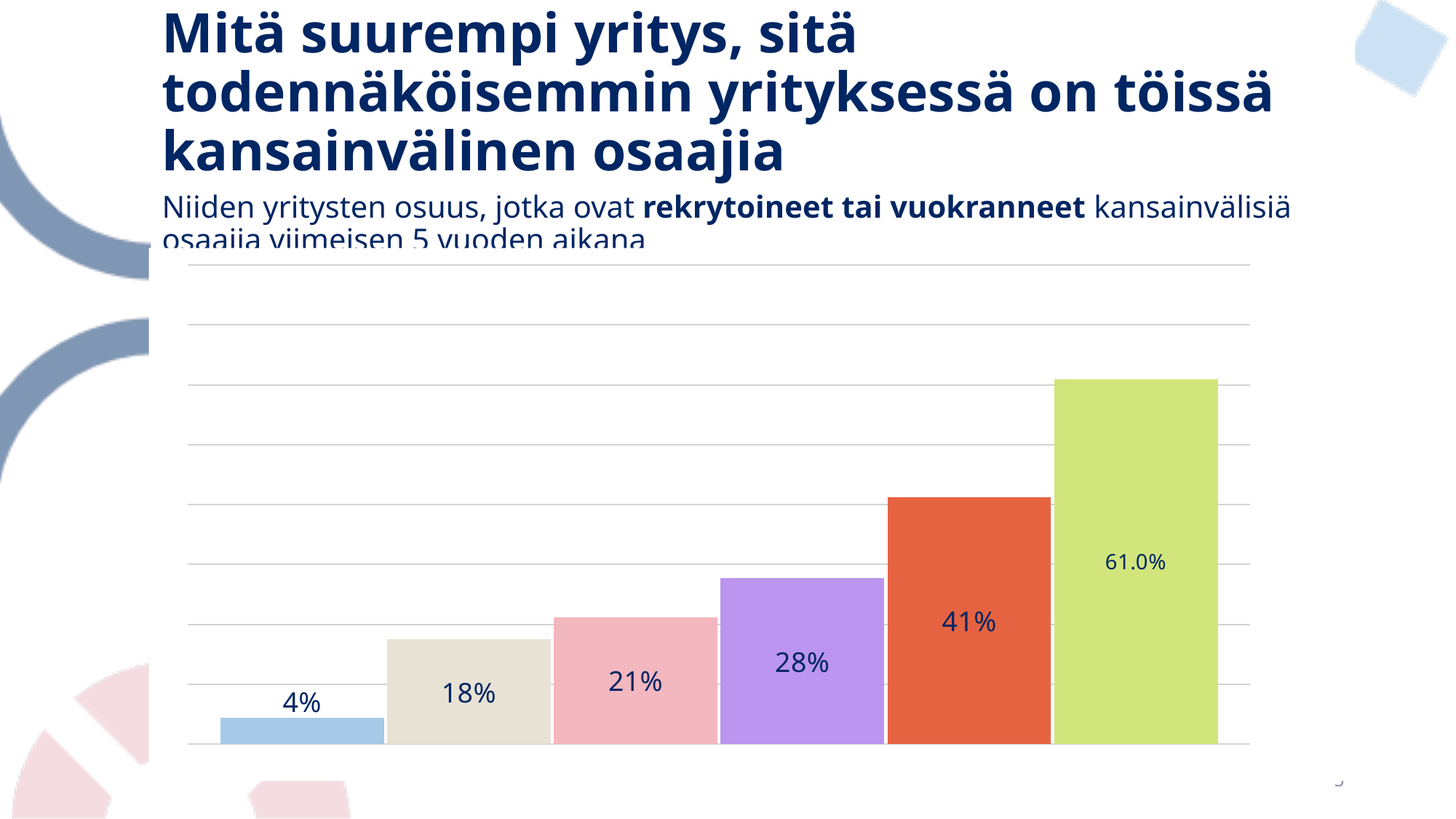
What is the value shown on the purple bar? 28% What type of chart is shown on the slide? bar chart Do the bar values rise or fall from left to right? rise What is the value shown on the pink bar (third from the left)? 21% Which bar has the highest value? the rightmost (yellow-green) bar, 61.0% Which bar has the lowest value? the leftmost (light blue) bar, 4% What is the value shown on the rightmost (yellow-green) bar? 61.0% What is the value shown on the leftmost (light blue) bar? 4% What is the value shown on the orange-red bar? 41% Which is larger, the value of the beige bar or the pink bar? the pink bar (21%) How many bars are plotted in the chart? 6 What is the difference between the value of the rightmost bar and the orange-red bar? 20 percentage points